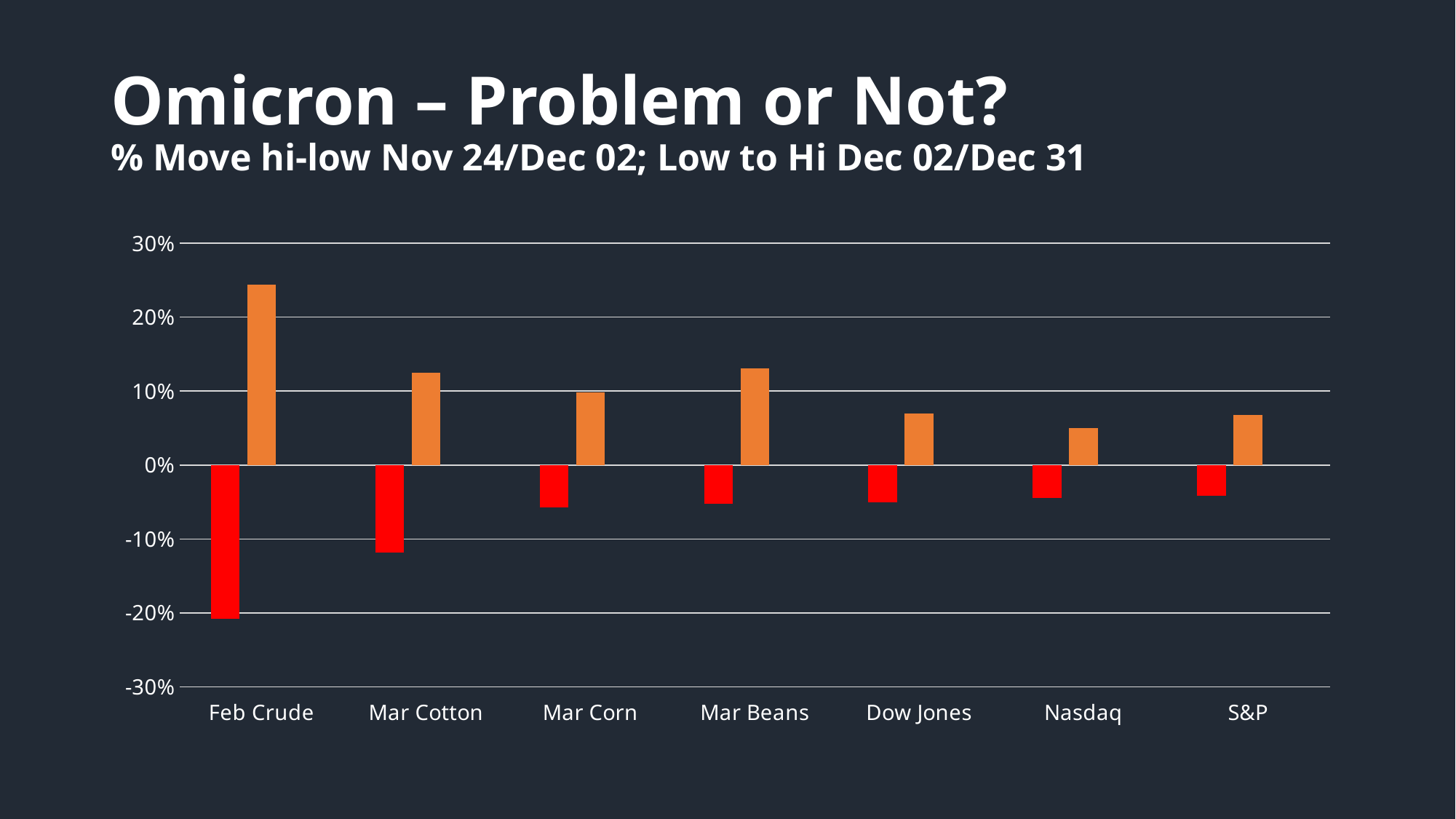
What kind of chart is shown on the slide? bar chart How many categories are shown on the x axis of the chart? 7 Which has the larger orange bar, Mar Beans or Mar Corn? Mar Beans Is the red bar for Mar Cotton greater or less than -10%? less Is the orange bar for Feb Crude greater or less than 20%? greater Is the orange bar for Dow Jones greater or less than 10%? less Which category has the lowest red (negative) bar? Feb Crude Which category has the tallest orange (positive) bar? Feb Crude Which has the larger (more negative) red bar, Mar Cotton or Mar Corn? Mar Cotton What colour are the bars that extend below 0% on the chart? red